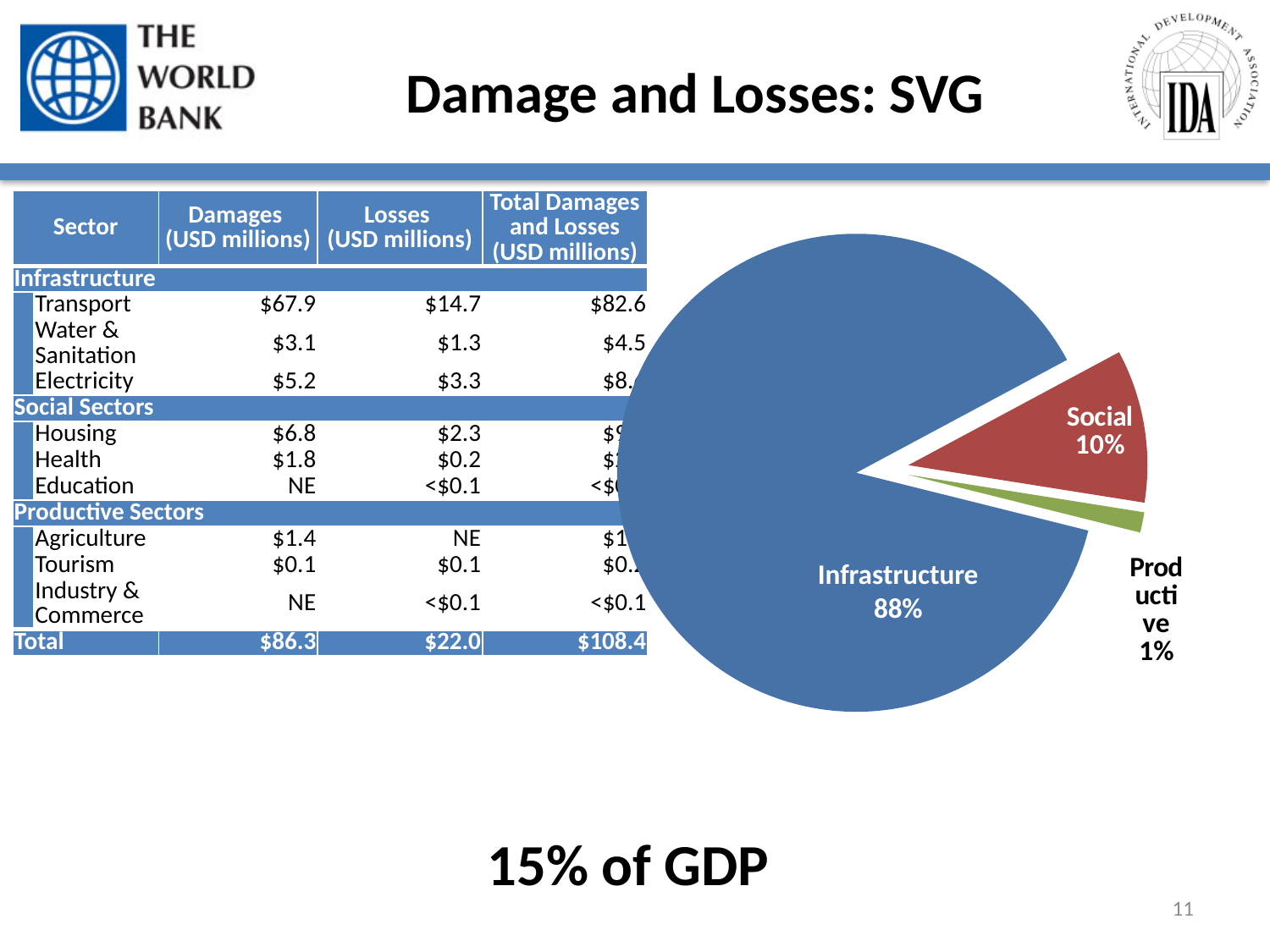
Which sector has the largest slice in the pie chart? Infrastructure What percentage is shown for the Productive slice of the pie chart? 1% By how many percentage points does the Infrastructure slice exceed the Social slice? 78 percentage points Which slice is larger in the pie chart, Social or Productive? Social By how many percentage points does the Social slice exceed the Productive slice? 9 percentage points What share of the pie does Infrastructure account for? 88% Which sector has the smallest slice in the pie chart? Productive What percentage is shown for the Social slice of the pie chart? 10% How many slices does the pie chart have? 3 What colour is the Social slice in the pie chart? red What colour is the Infrastructure slice in the pie chart? blue What kind of chart is shown on the slide? pie chart